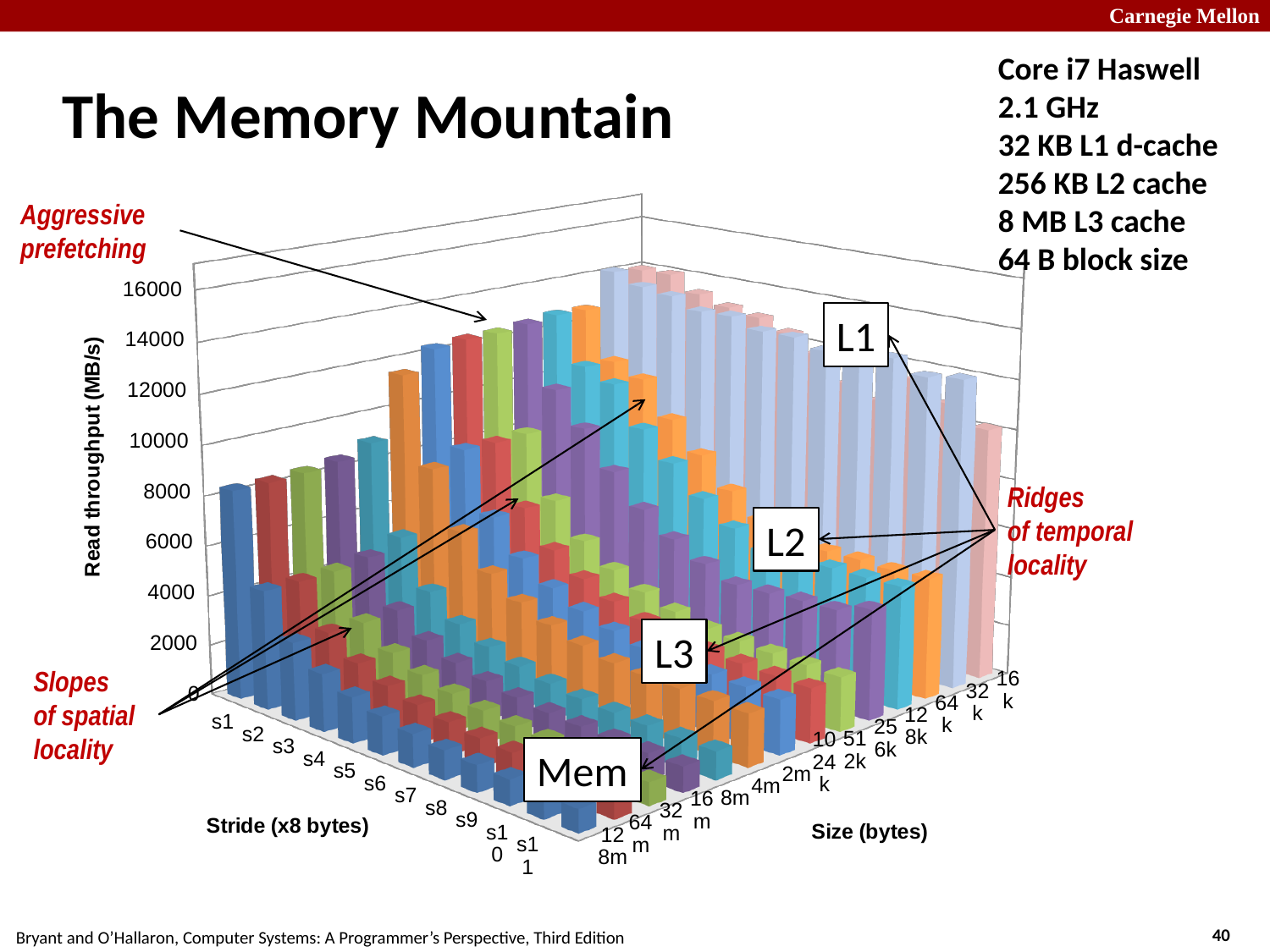
What is the highest tick value shown on the read throughput axis? 16000 What kind of chart is shown on the slide? bar chart Which size has the higher read throughput at stride s1, 16k or 128m? 16k For size 128m, does read throughput rise or fall as the stride increases from s1 to s11? fall Which stride has the higher read throughput at size 128m, s1 or s11? s1 Is the read throughput for stride s11 at size 128m greater or less than 4000? less Is the read throughput for stride s1 at size 128m greater or less than 4000? greater Is the read throughput for stride s1 at size 128m greater or less than 12000? less Which memory level label on the chart is placed at the lowest region of the mountain? Mem What is the label on the vertical axis of the chart? Read throughput (MB/s) What is the title of the chart on the slide? The Memory Mountain How many stride categories (s1 through s11) are shown along the stride axis? 11